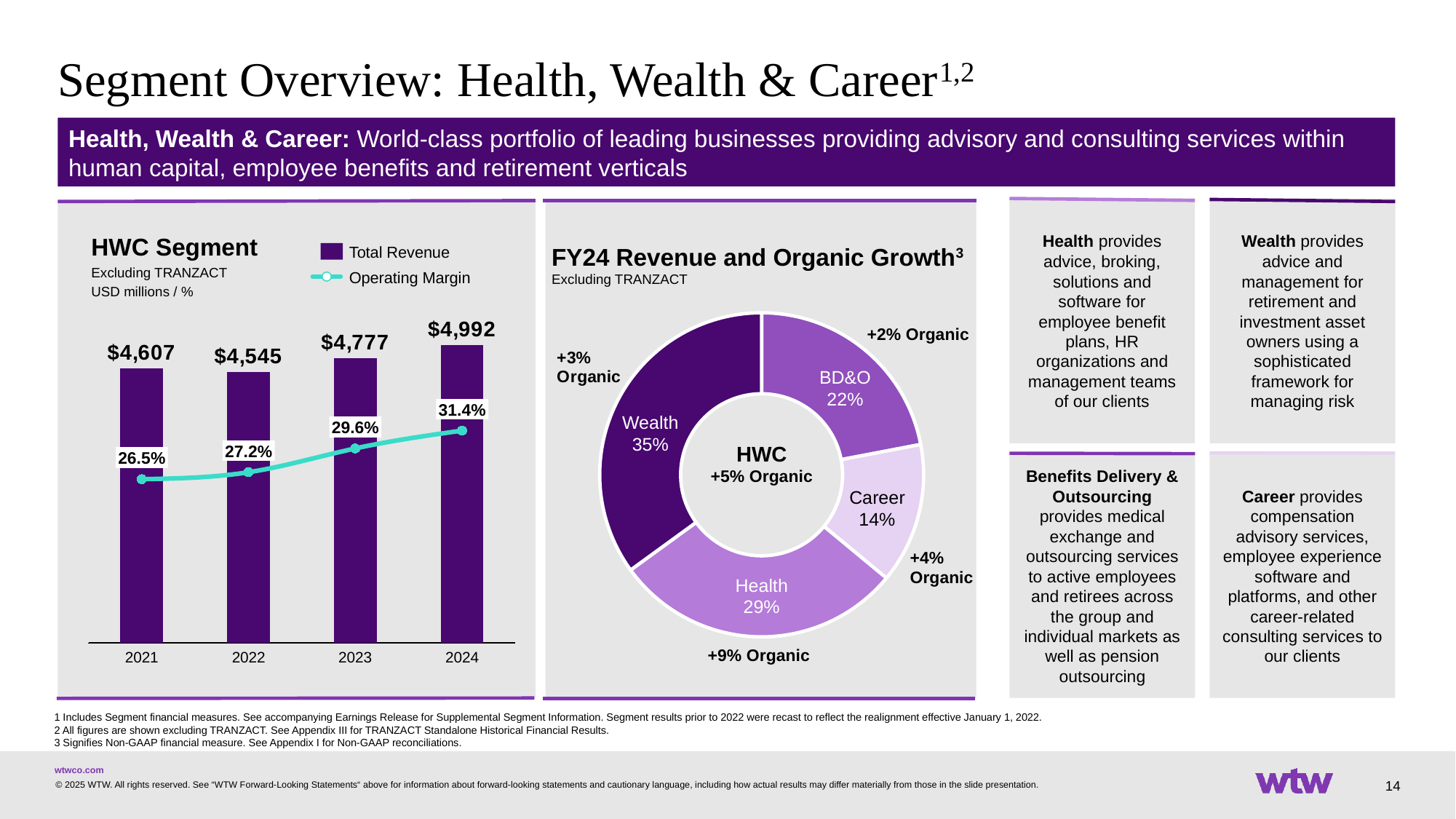
In the HWC Segment chart, what was Total Revenue in 2024? $4,992 In the FY24 Revenue and Organic Growth chart, what share of revenue does Wealth represent? 35% In the HWC Segment chart, what was the Operating Margin in 2022? 27.2% What kind of chart is the FY24 Revenue and Organic Growth chart? Donut (pie) chart In the HWC Segment chart, what is the difference in Total Revenue between 2024 and 2023? $215 In the HWC Segment chart, which year had the lowest Total Revenue? 2022 In the HWC Segment chart, how many series does the legend list? 2 In the HWC Segment chart, which year had the highest Operating Margin? 2024 In the HWC Segment chart, how many years are shown on the x axis? 4 In the FY24 Revenue and Organic Growth chart, which business has the smallest share of revenue? Career In the FY24 Revenue and Organic Growth chart, what is the organic growth shown for Health? +9% Organic In the HWC Segment chart, does the Operating Margin rise or fall from 2021 to 2024? rise